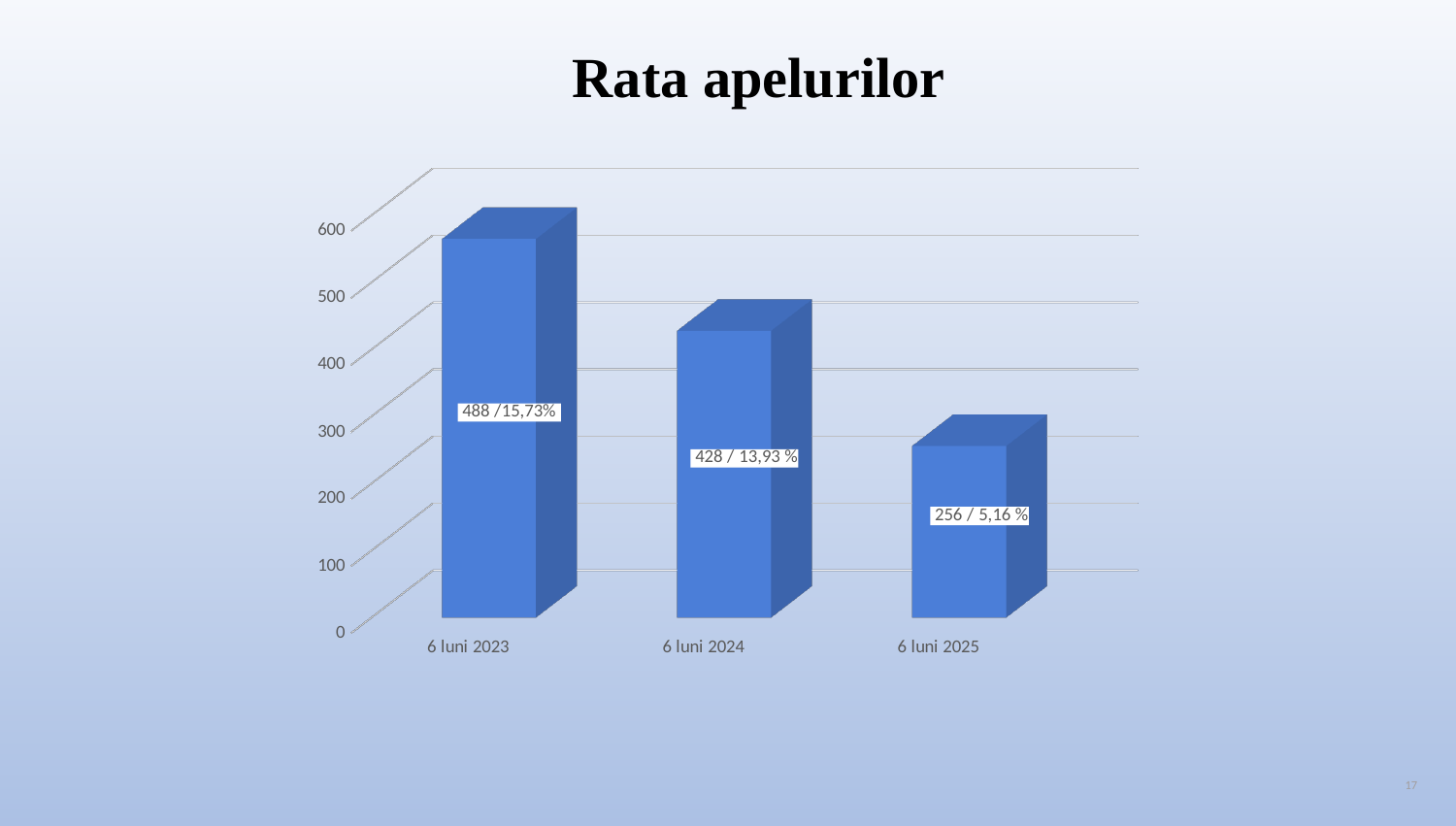
Which period has the lowest value? 6 luni 2025 What is the difference between the count for 6 luni 2024 (428) and the count for 6 luni 2025 (256)? 172 Which is larger, the value for 6 luni 2024 or the value for 6 luni 2025? 6 luni 2024 What kind of chart is shown on the slide? bar chart What data label is shown for 6 luni 2024? 428 / 13,93 % What data label is shown for 6 luni 2023? 488 /15,73% How many periods are shown on the x axis? 3 Which period has the highest value? 6 luni 2023 Is the value for 6 luni 2025 greater or less than 300? less What is the difference between the count for 6 luni 2023 (488) and the count for 6 luni 2024 (428)? 60 What data label is shown for 6 luni 2025? 256 / 5,16 % Do the values rise or fall from 6 luni 2023 to 6 luni 2025? fall